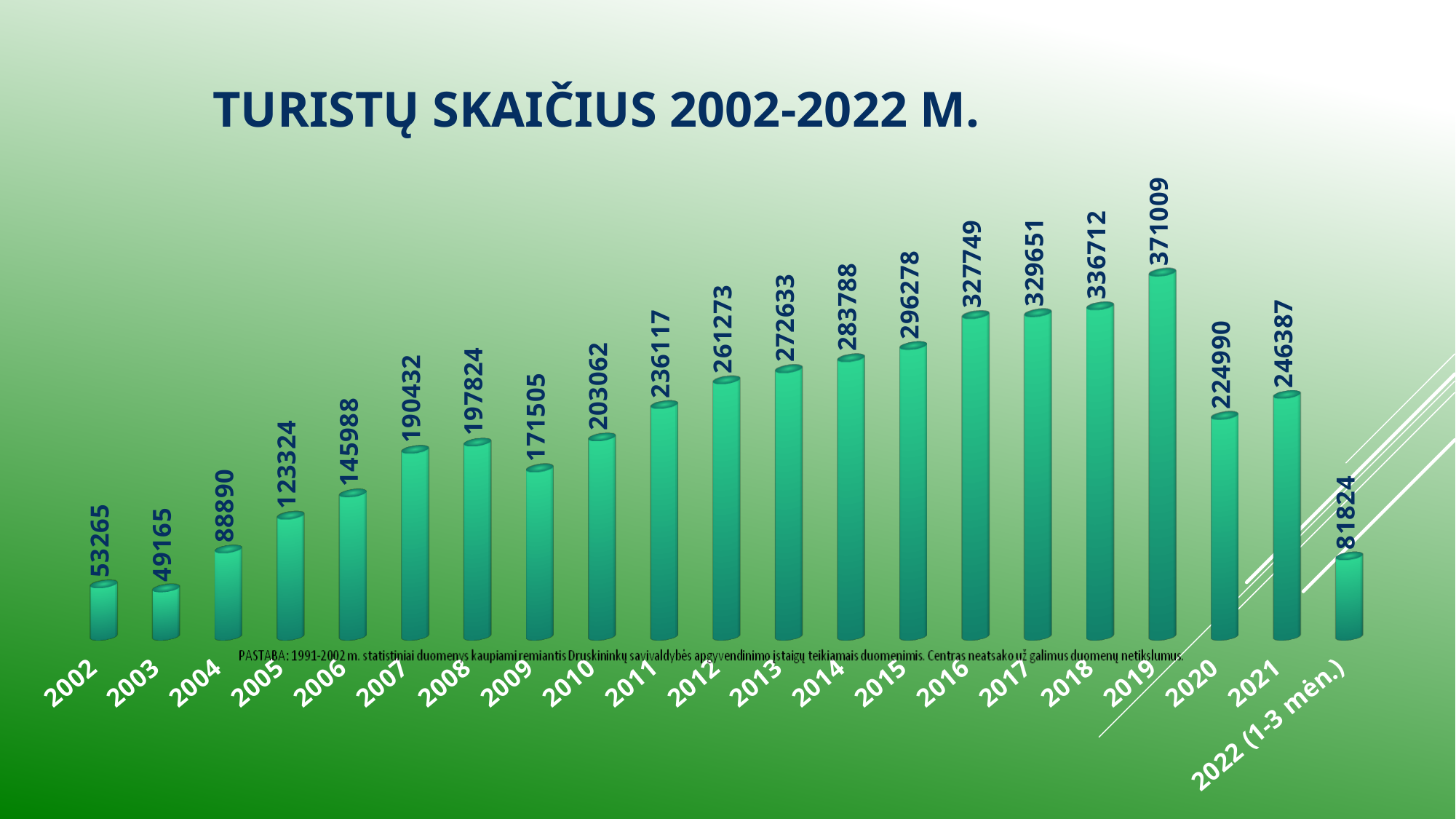
How many years (categories) are plotted in the chart? 21 Do the values rise or fall from 2010 to 2019? rise What is the value shown for 2002? 53265 What is the number of tourists shown for 2019? 371009 What type of chart is shown on the slide? bar chart Which year has the highest number of tourists? 2019 What is the difference between the values for 2019 and 2018? 34297 What is the difference between the values for 2021 and 2020? 21397 What is the title of the chart? TURISTŲ SKAIČIUS 2002-2022 M. Which is larger, the value for 2009 or the value for 2010? 2010 Which year has the lowest number of tourists? 2003 What is the value shown for 2022 (1-3 mėn.)? 81824